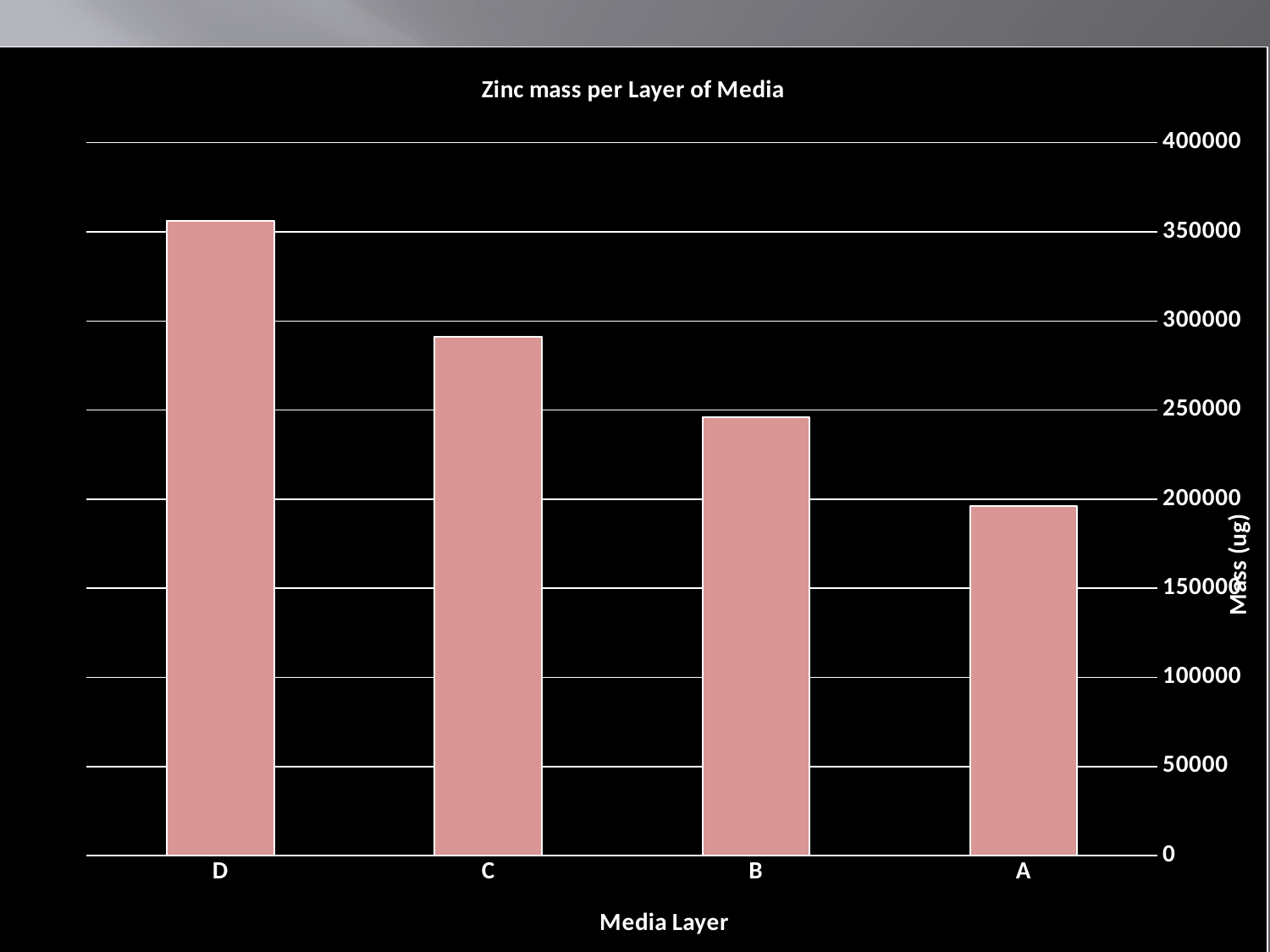
What type of chart is shown on the slide? bar chart What is the label of the x axis? Media Layer Is the value for layer C greater or less than 300000? less Which has a larger zinc mass, layer C or layer B? C Do the values rise or fall moving from D to A along the x axis? fall Is the value for layer D greater or less than 300000? greater Which media layer has the lowest zinc mass? A Is the value for layer B greater or less than 200000? greater What is the title of the chart? Zinc mass per Layer of Media Which has a larger zinc mass, layer D or layer A? D Which media layer has the highest zinc mass? D How many media layers are plotted on the chart? 4